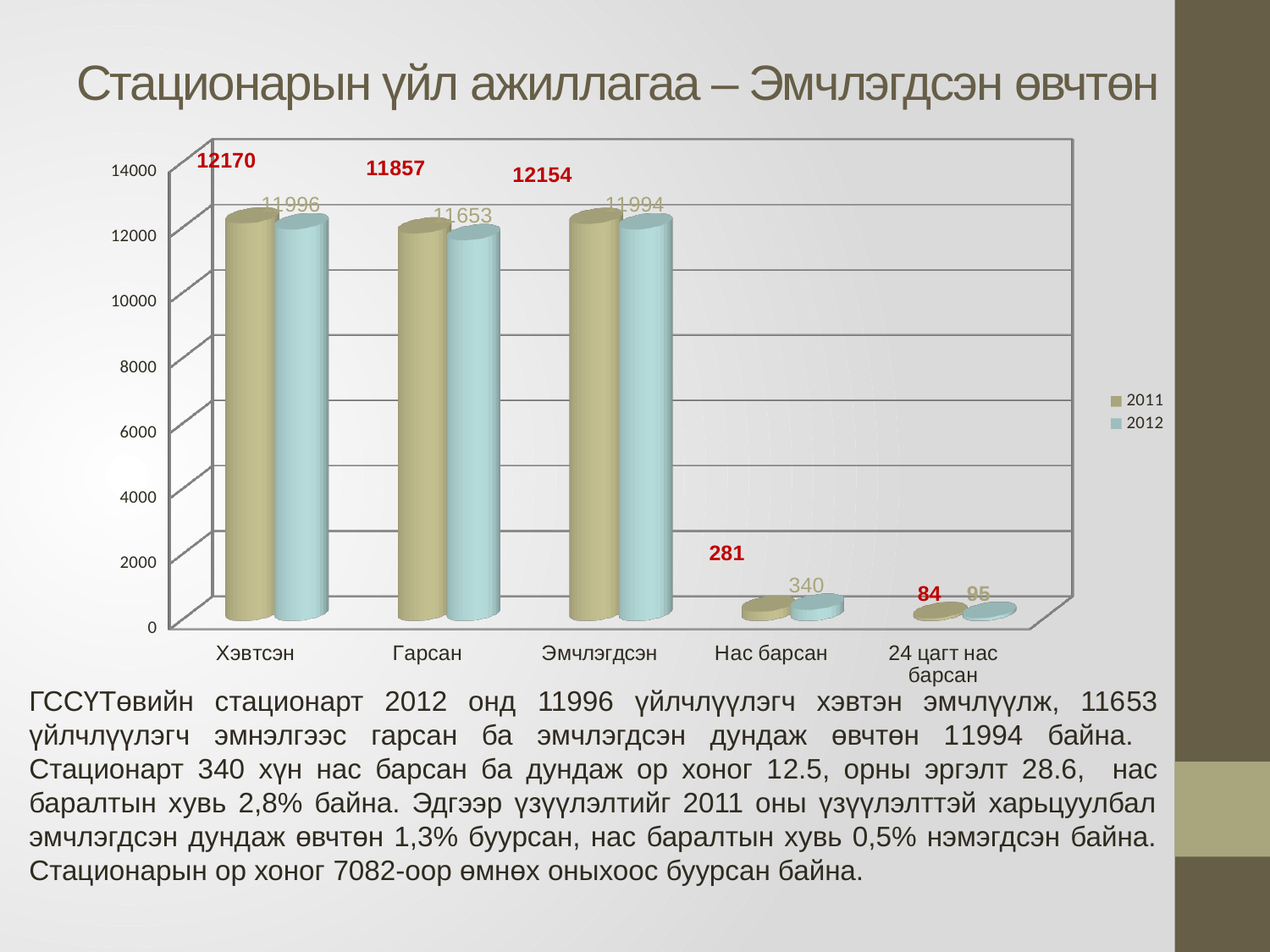
For Нас барсан, which year has the larger value, 2011 or 2012? 2012 Which category has the lowest 2012 value? 24 цагт нас барсан What kind of chart is shown on the slide? Bar chart What is the 2012 value for Нас барсан? 340 What is the 2012 value for Гарсан? 11653 Which category has the highest 2011 value? Хэвтсэн What is the 2011 value for 24 цагт нас барсан? 84 How many categories are shown on the x axis? 5 What is the 2011 value for Хэвтсэн? 12170 How many series does the legend list? 2 Is the 2012 value for Хэвтсэн greater or less than 10000? greater What is the difference between the 2011 and 2012 values for Эмчлэгдсэн? 160